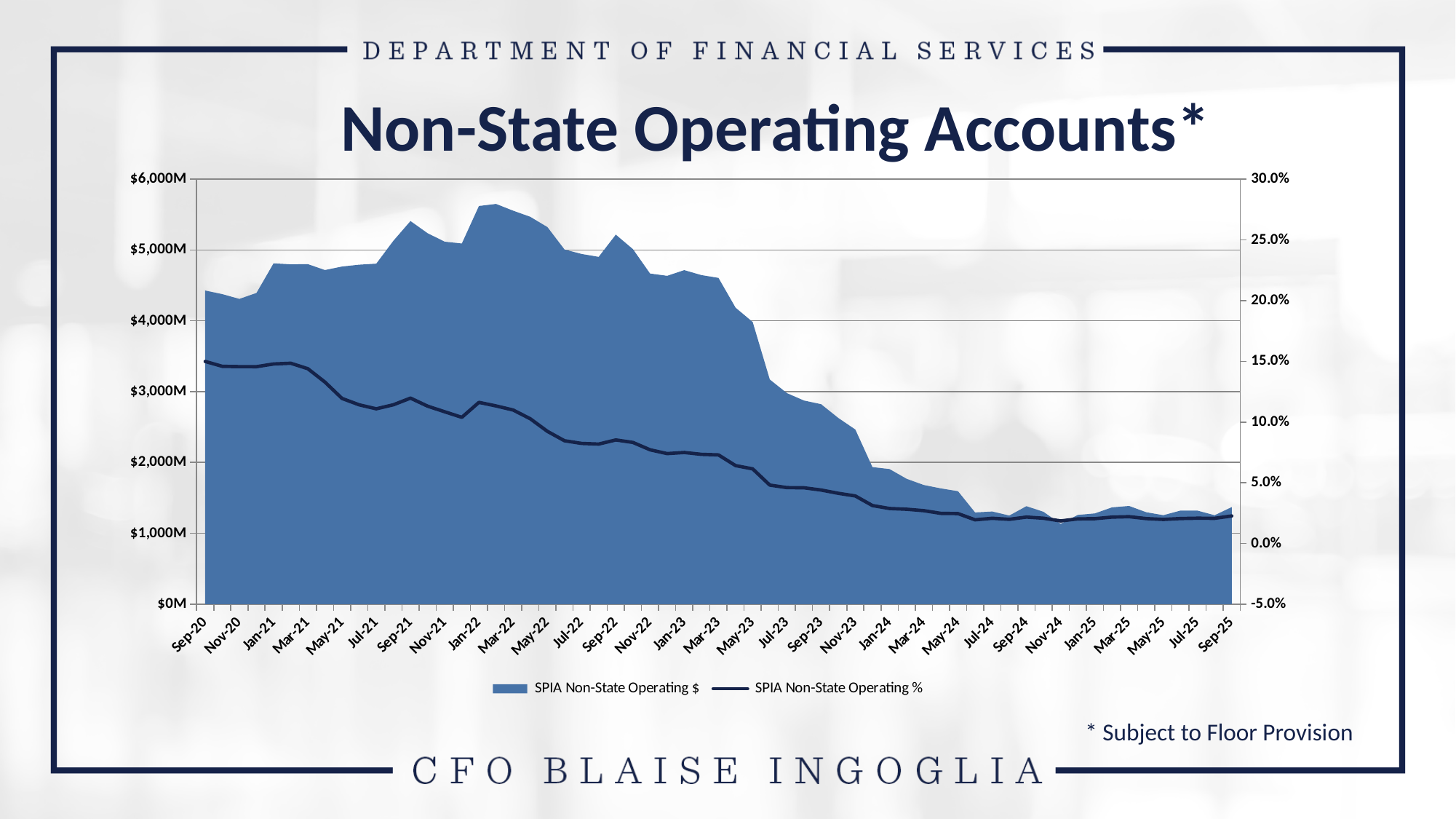
Is the SPIA Non-State Operating $ value for Sep-20 greater or less than $4,000M? greater How many series does the legend list? 2 How many month labels are shown on the x axis? 31 What is the title of the chart? Non-State Operating Accounts* Is the SPIA Non-State Operating $ value for Sep-25 greater or less than $2,000M? less Is the SPIA Non-State Operating % value for Sep-25 greater or less than 5.0%? less Which is larger, the SPIA Non-State Operating $ value for Jan-22 or for Jan-24? Jan-22 Does the SPIA Non-State Operating $ series generally rise or fall from Sep-20 to Sep-25? fall Does the SPIA Non-State Operating % line generally rise or fall from Sep-20 to Sep-25? fall What kind of chart is shown on the slide? A combination area and line chart What does the footnote marked by the asterisk say? Subject to Floor Provision